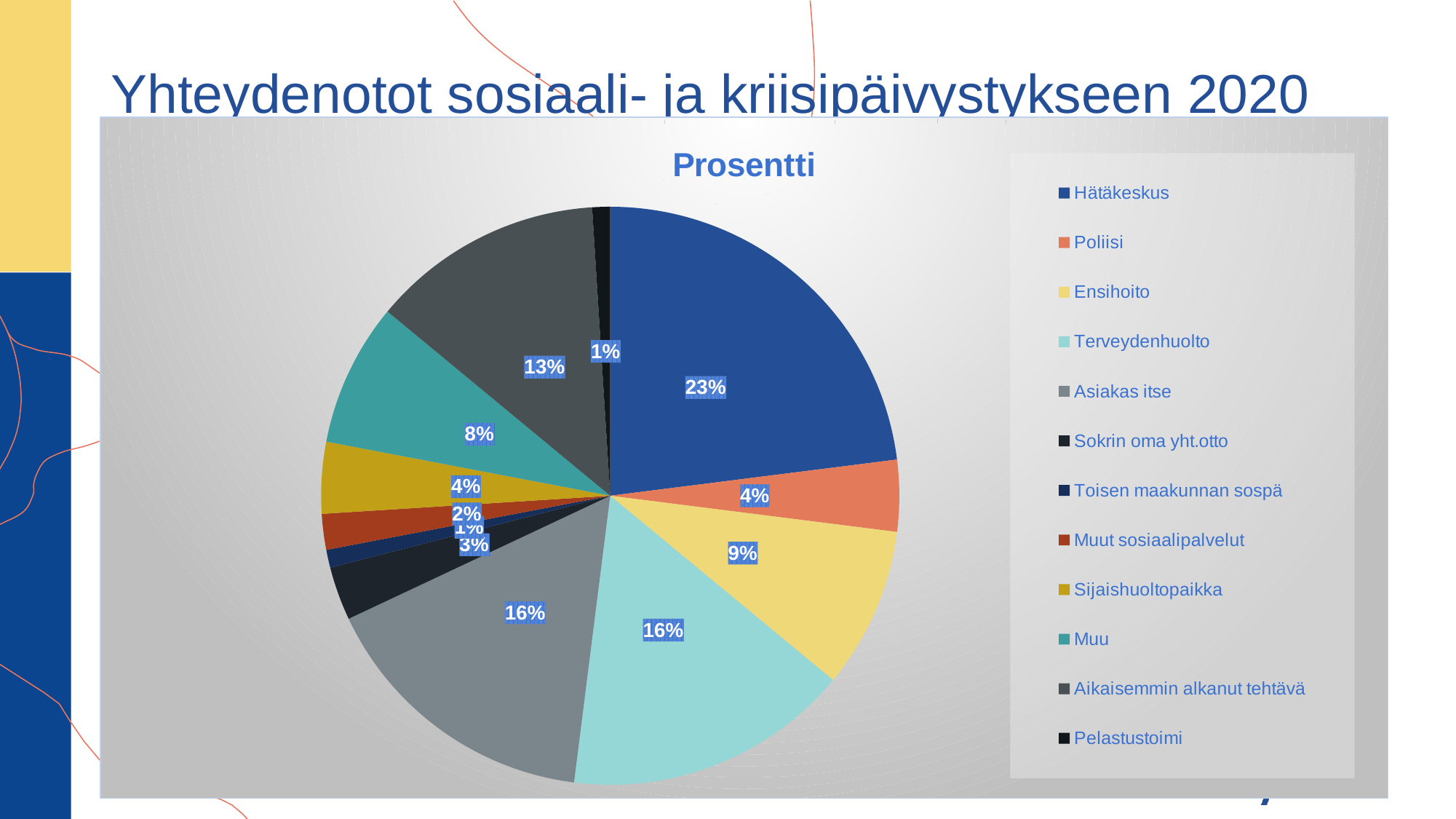
What is the value for Ensihoito? 9% What kind of chart is shown on the slide? Pie chart What is the combined share of Terveydenhuolto and Asiakas itse? 32% What is the value for Aikaisemmin alkanut tehtävä? 13% Which category has the largest slice of the pie? Hätäkeskus What percentage is shown for Muu? 8% What is the title of the chart? Prosentti What is the difference between the Hätäkeskus share and the Asiakas itse share? 7% Which is larger, the share for Poliisi or the share for Ensihoito? Ensihoito What percentage is shown for Terveydenhuolto? 16% How many categories does the pie chart show? 12 What share of the pie does Hätäkeskus have? 23%